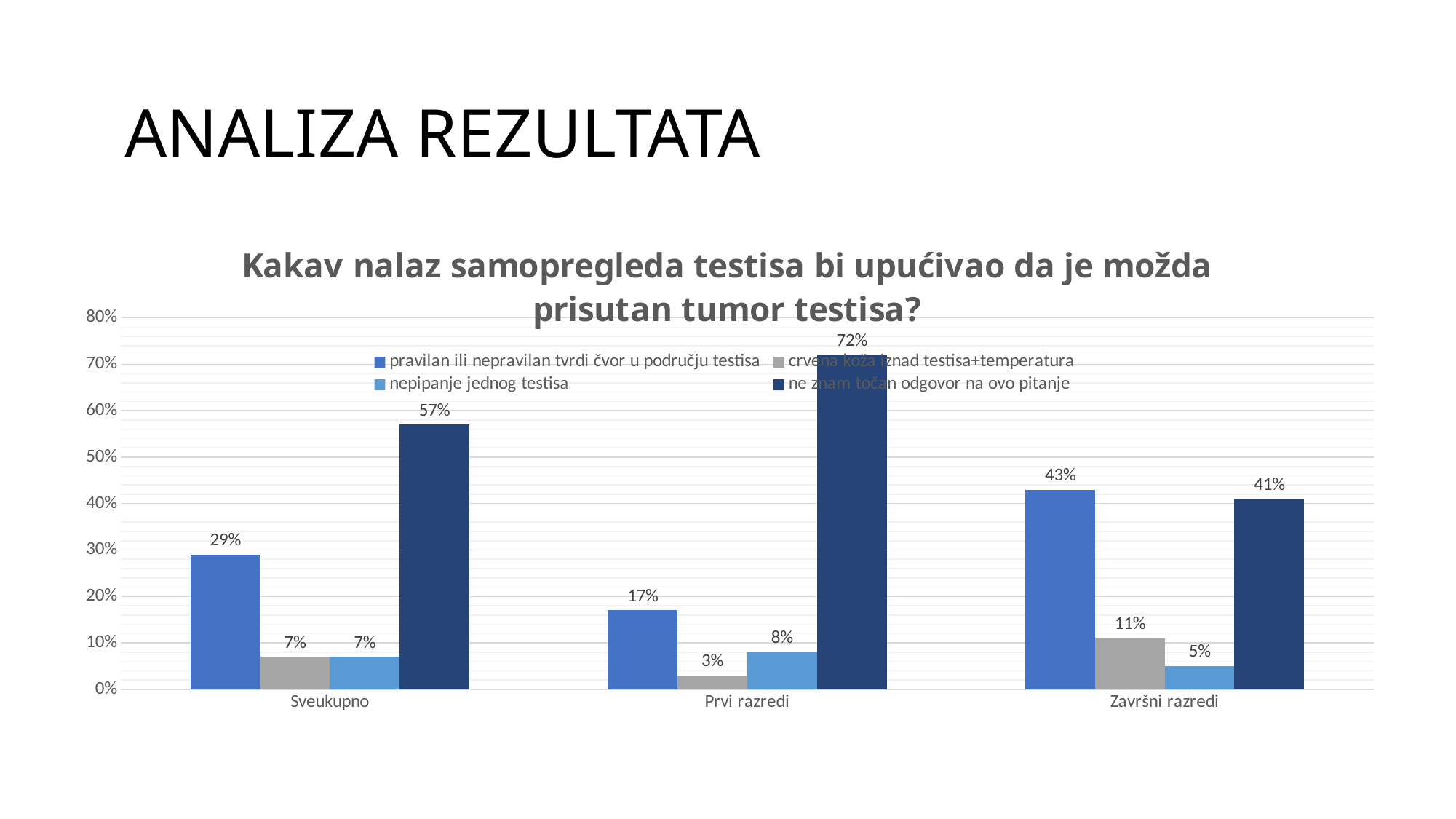
What is the value for 'pravilan ili nepravilan tvrdi čvor u području testisa' in the Sveukupno group? 29% What is the value for 'ne znam točan odgovor na ovo pitanje' in the Prvi razredi group? 72% How many category groups are shown on the x axis? 3 What is the value for 'crvena koža iznad testisa+temperatura' in the Završni razredi group? 11% What kind of chart is shown on the slide? bar chart What is the title of the chart? Kakav nalaz samopregleda testisa bi upućivao da je možda prisutan tumor testisa? How many series does the legend list? 4 What is the value for 'nepipanje jednog testisa' in the Prvi razredi group? 8% What is the difference between 'ne znam točan odgovor na ovo pitanje' and 'pravilan ili nepravilan tvrdi čvor u području testisa' in the Prvi razredi group? 55% Which series has the highest value in the Sveukupno group? ne znam točan odgovor na ovo pitanje Which series has the lowest value in the Prvi razredi group? crvena koža iznad testisa+temperatura Which is larger in the Završni razredi group: 'pravilan ili nepravilan tvrdi čvor u području testisa' or 'ne znam točan odgovor na ovo pitanje'? pravilan ili nepravilan tvrdi čvor u području testisa